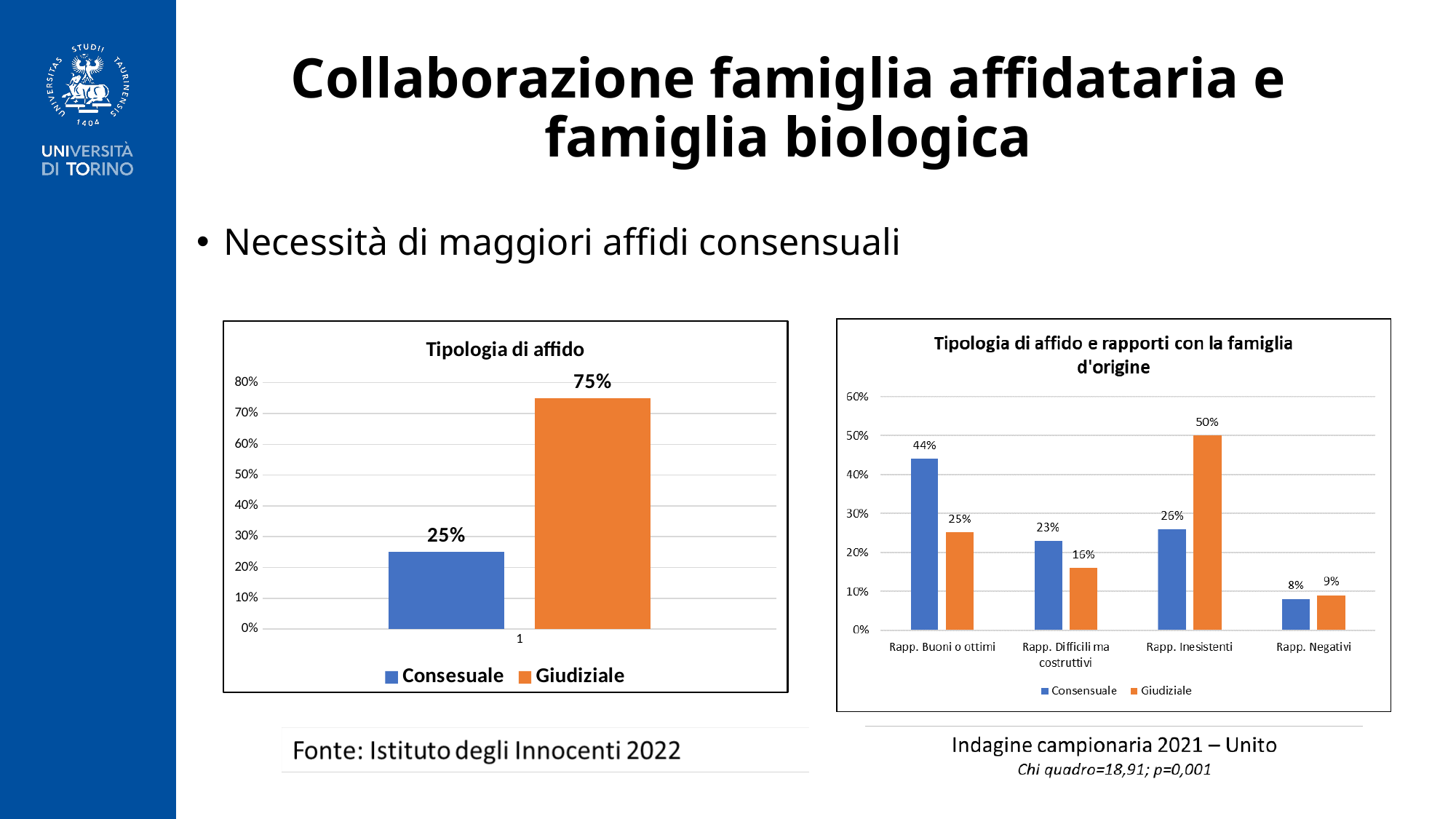
In the 'Tipologia di affido e rapporti con la famiglia d'origine' chart, which is larger for Rapp. Difficili ma costruttivi: Consensuale or Giudiziale? Consensuale In the 'Tipologia di affido e rapporti con la famiglia d'origine' chart, how many categories are shown on the x axis? 4 In the 'Tipologia di affido e rapporti con la famiglia d'origine' chart, what is the difference between the Consensuale and Giudiziale values for Rapp. Buoni o ottimi? 19% In the 'Tipologia di affido' chart, what is the value for Consesuale? 25% In the 'Tipologia di affido e rapporti con la famiglia d'origine' chart, what is the Giudiziale value for Rapp. Inesistenti? 50% In the 'Tipologia di affido' chart, what is the value for Giudiziale? 75% In the 'Tipologia di affido e rapporti con la famiglia d'origine' chart, which category has the lowest Consensuale value? Rapp. Negativi In the 'Tipologia di affido e rapporti con la famiglia d'origine' chart, what is the Consensuale value for Rapp. Buoni o ottimi? 44% In the 'Tipologia di affido' chart, how many series does the legend list? 2 What kind of chart is 'Tipologia di affido'? Bar chart In the 'Tipologia di affido e rapporti con la famiglia d'origine' chart, which category has the highest Giudiziale value? Rapp. Inesistenti In the 'Tipologia di affido' chart, what is the difference between the Giudiziale and Consesuale values? 50%